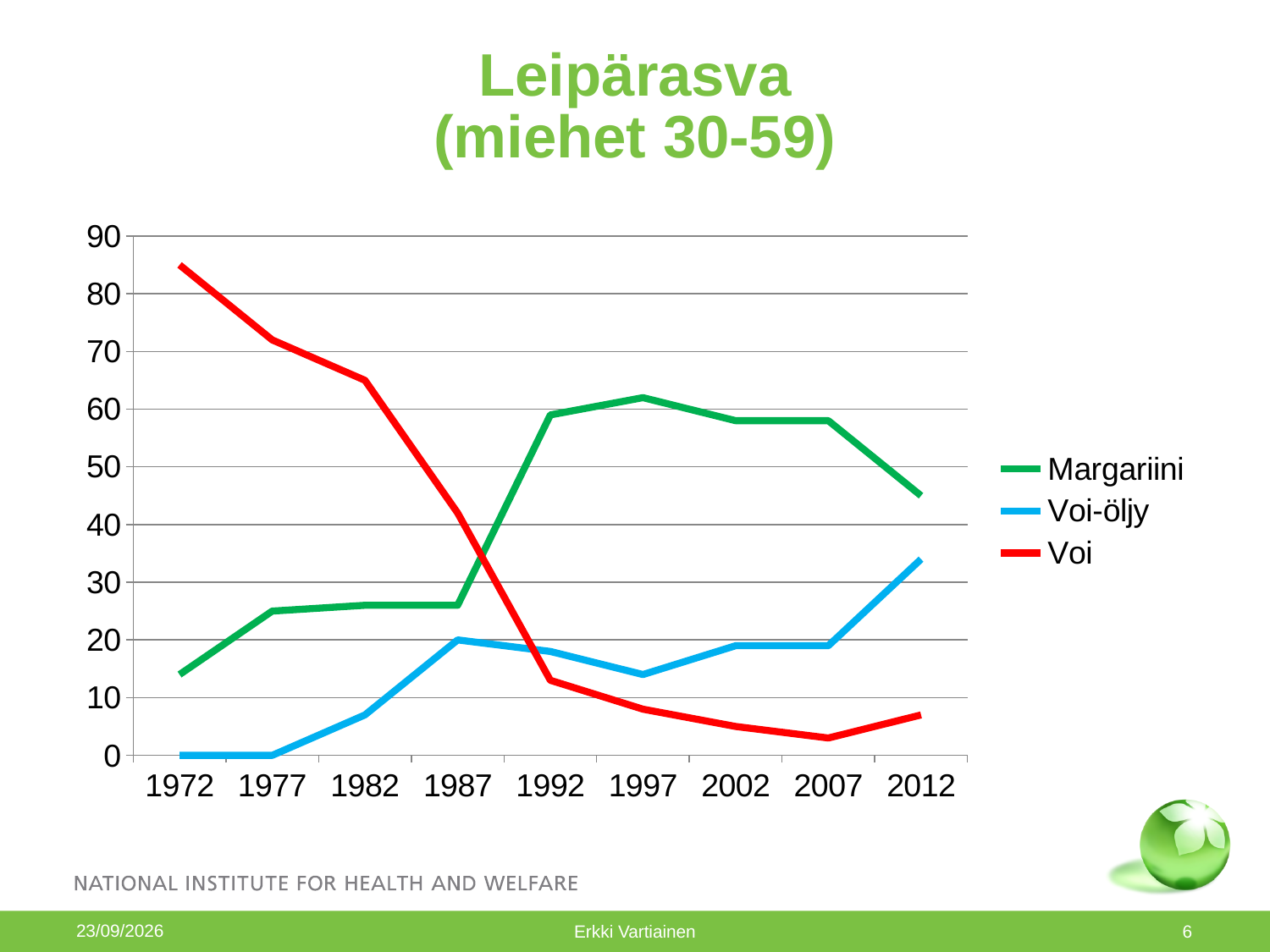
Which series has the highest value in 1972? Voi Does the Voi series rise or fall from 1972 to 2007? fall Which series has the highest value in 2012? Margariini What kind of chart is shown on the slide? line chart How many series does the legend list? 3 Is the value for Voi in 1972 greater or less than 80? greater How many years are shown on the x axis? 9 Is the value for Margariini in 1997 greater or less than 60? greater Is the value for Voi-öljy in 2012 greater or less than 30? greater What is the value for Voi-öljy in 1972? 0 Which is larger in 1987, Margariini or Voi? Voi Which series has the lowest value in 2007? Voi